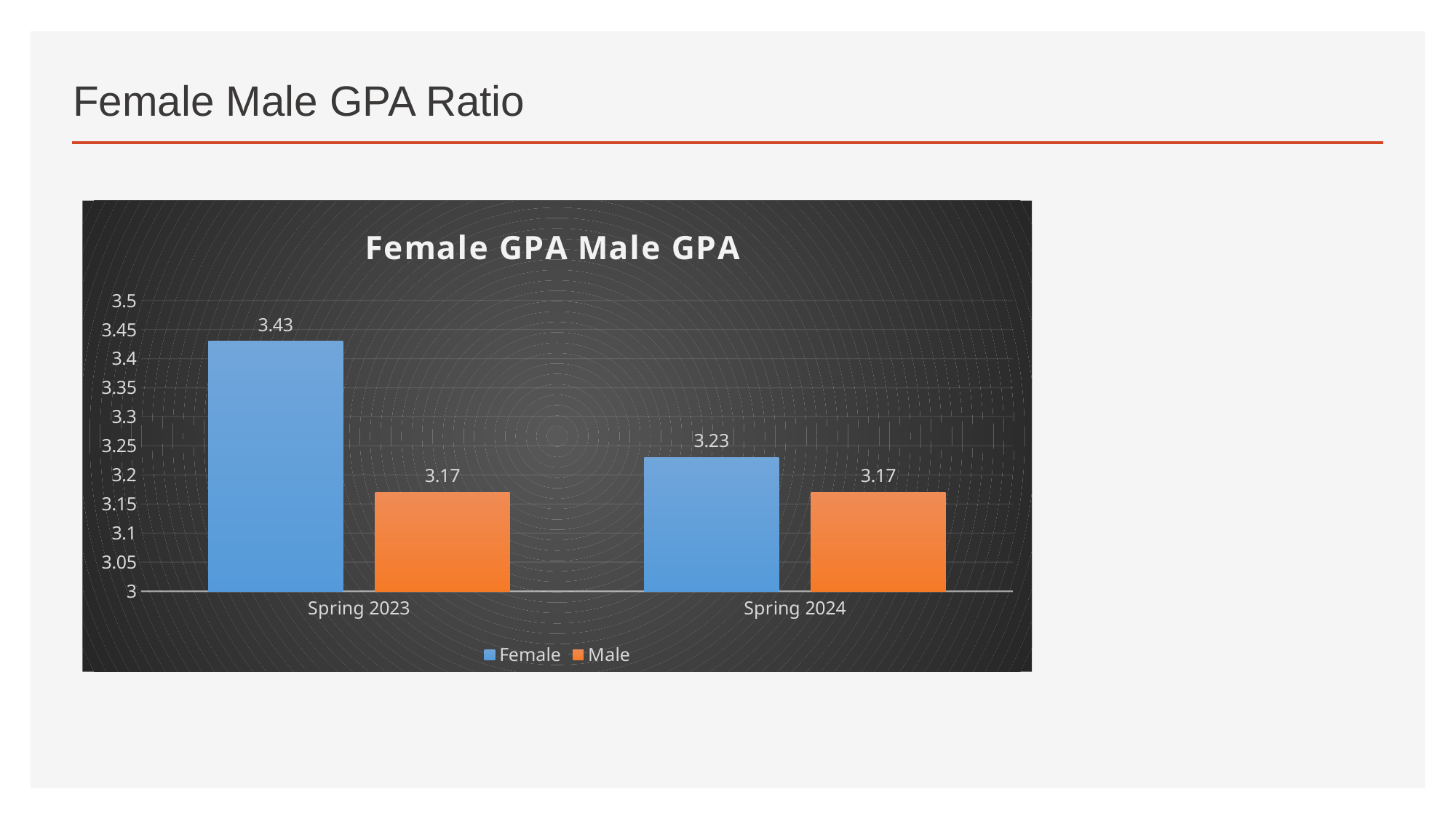
What kind of chart is shown on the slide? Bar chart What is the difference between the Female GPA in Spring 2023 and the Female GPA in Spring 2024? 0.2 What is the difference between the Female GPA and the Male GPA in Spring 2023? 0.26 Which semester has the highest Female GPA? Spring 2023 What is the Female GPA for Spring 2024? 3.23 How many semesters are shown on the x axis? 2 What is the Male GPA for Spring 2024? 3.17 How many series does the legend list? 2 What is the Male GPA for Spring 2023? 3.17 Which is larger in Spring 2024, the Female GPA or the Male GPA? Female GPA What is the Female GPA for Spring 2023? 3.43 Does the Female GPA rise or fall from Spring 2023 to Spring 2024? Fall